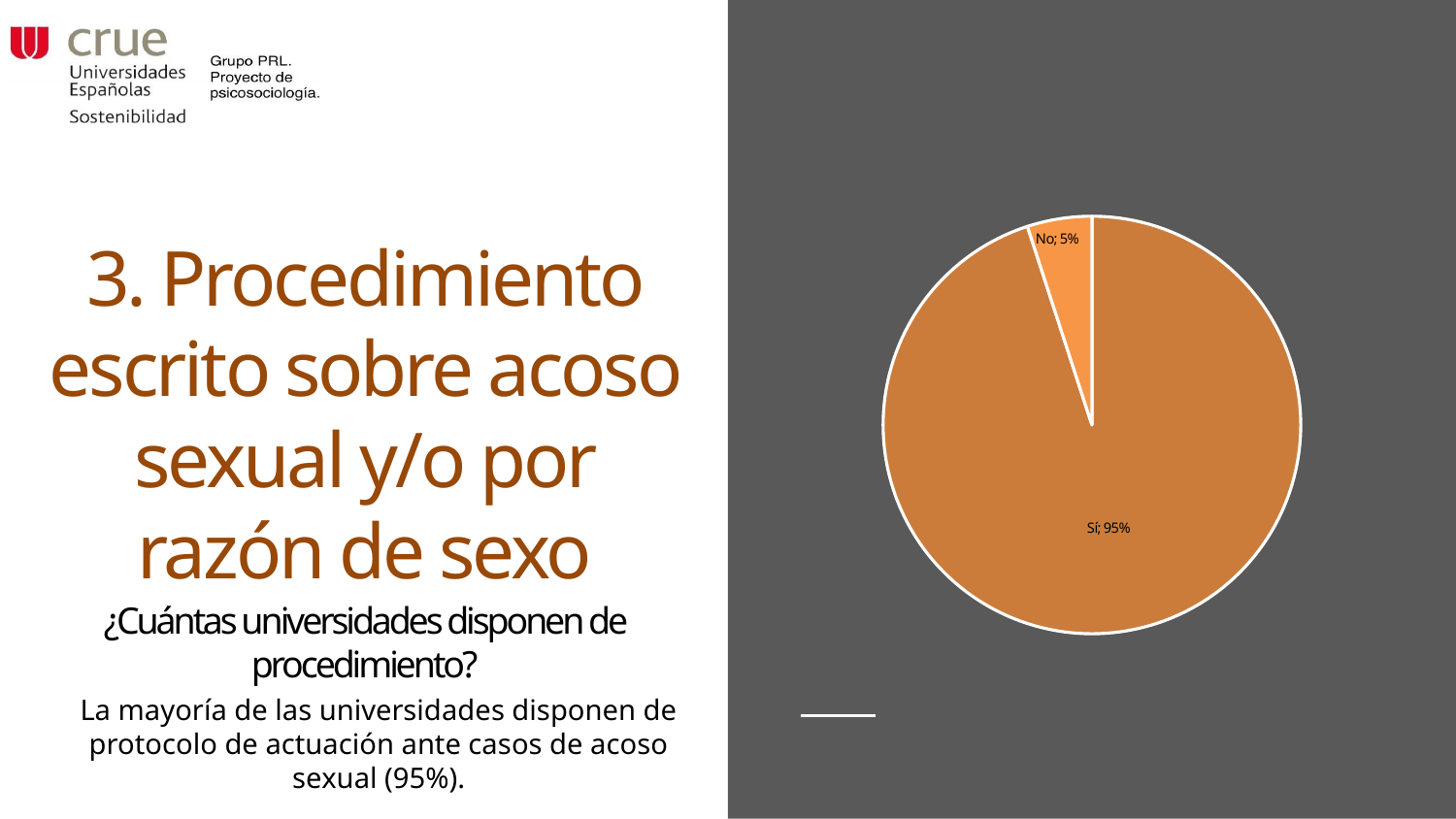
What is the difference in percentage points between the "Sí" and "No" slices? 90 What share of the pie does the "No" slice represent? 5% What is the total of the two slice percentages shown on the pie chart? 100% What colour is the "Sí" slice of the pie chart? orange Which slice of the pie is the largest? Sí What percentage of the pie is labelled "Sí"? 95% Which slice is larger, "Sí" or "No"? Sí What percentage of the pie is labelled "No"? 5% How many slices does the pie chart have? 2 Which slice of the pie is the smallest? No What kind of chart is shown on the slide? pie chart